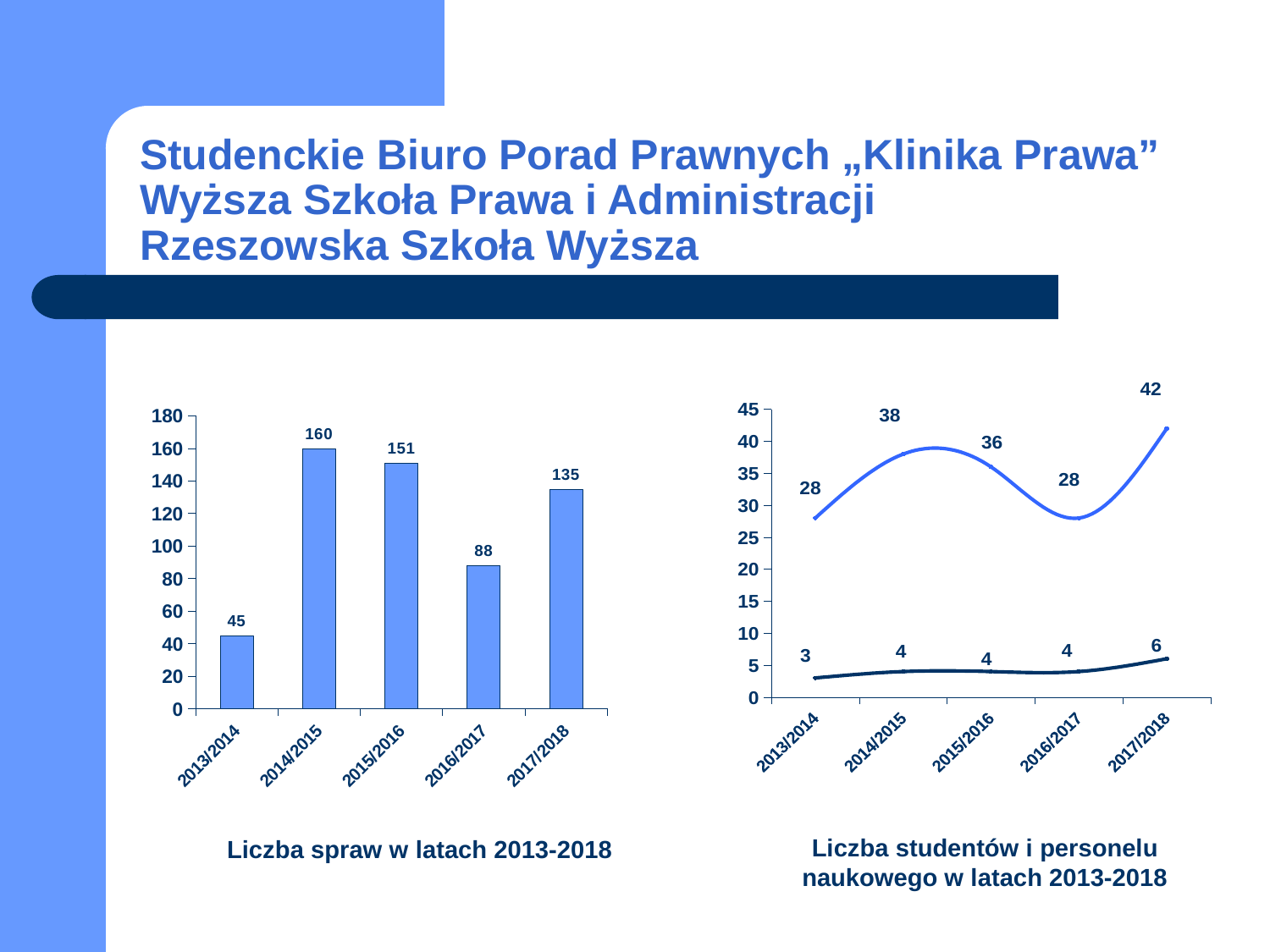
In the right chart (Liczba studentów i personelu naukowego w latach 2013-2018), what is the value of the upper line for 2017/2018? 42 In the left chart (Liczba spraw w latach 2013-2018), what is the value for 2016/2017? 88 What type of chart is the left chart (Liczba spraw w latach 2013-2018)? bar chart In the right chart (Liczba studentów i personelu naukowego w latach 2013-2018), what is the value of the lower line for 2013/2014? 3 In the left chart (Liczba spraw w latach 2013-2018), which year has the lowest value? 2013/2014 In the right chart (Liczba studentów i personelu naukowego w latach 2013-2018), which of the upper line's values is larger: 2014/2015 or 2016/2017? 2014/2015 In the left chart (Liczba spraw w latach 2013-2018), what is the difference between the values for 2015/2016 and 2017/2018? 16 In the left chart (Liczba spraw w latach 2013-2018), which year has the highest value? 2014/2015 In the right chart (Liczba studentów i personelu naukowego w latach 2013-2018), what is the difference between the upper line's values for 2014/2015 and 2015/2016? 2 What type of chart is the right chart (Liczba studentów i personelu naukowego w latach 2013-2018)? line chart In the left chart (Liczba spraw w latach 2013-2018), what is the value for 2014/2015? 160 In the left chart (Liczba spraw w latach 2013-2018), how many bars are shown? 5